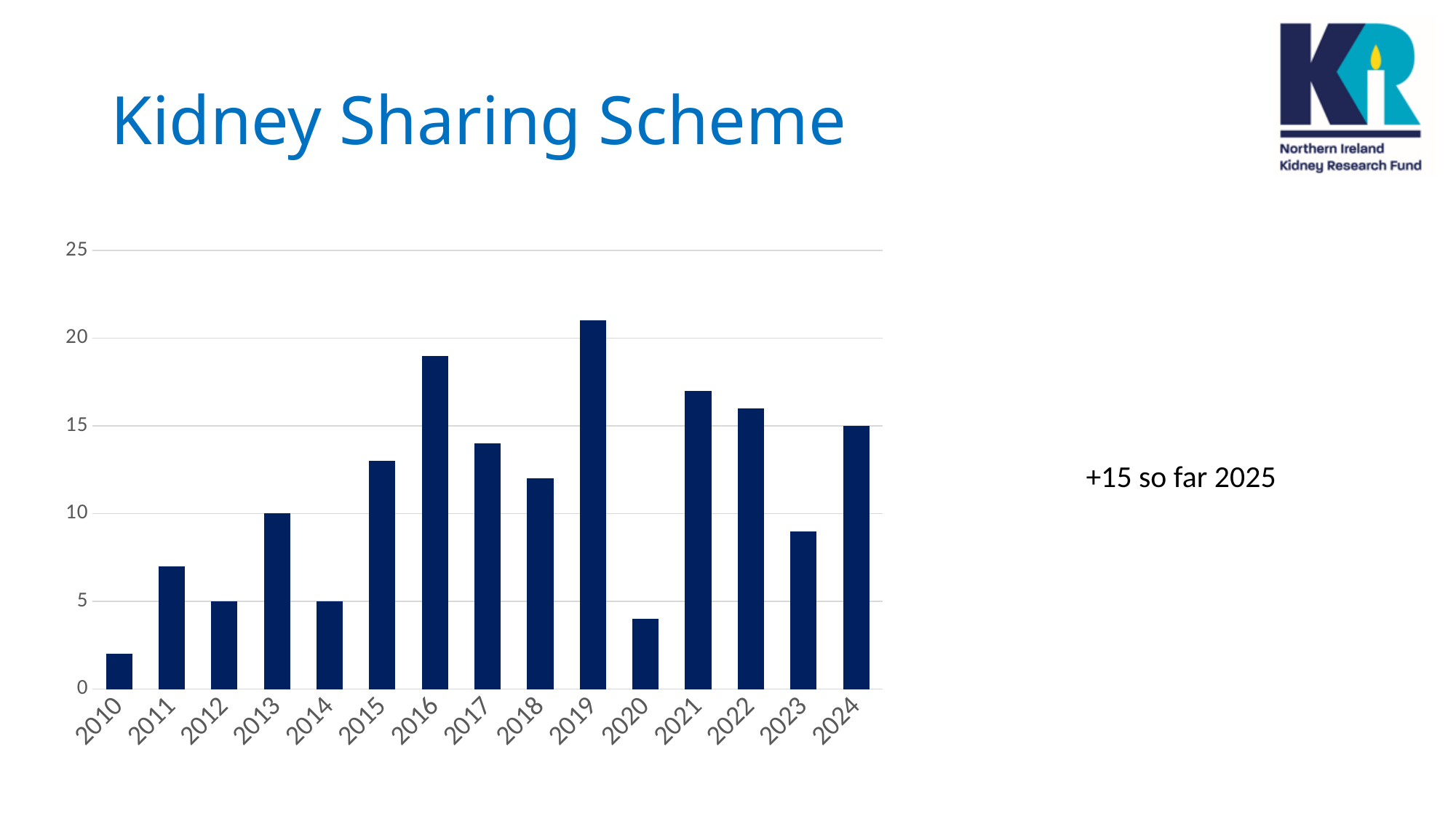
What is the difference between the values for 2024 and 2014? 10 Which is larger, the value for 2016 or the value for 2017? 2016 What type of chart is shown on the slide? Bar chart Which year has the lowest bar in the chart? 2010 What is the value for 2013? 10 Is the value for 2020 greater or less than 5? less What is the value for 2012? 5 What is the title of the slide containing the chart? Kidney Sharing Scheme What is the value for 2024? 15 Is the value for 2019 greater or less than 20? greater How many years are shown on the x axis of the chart? 15 Which year has the highest bar in the chart? 2019